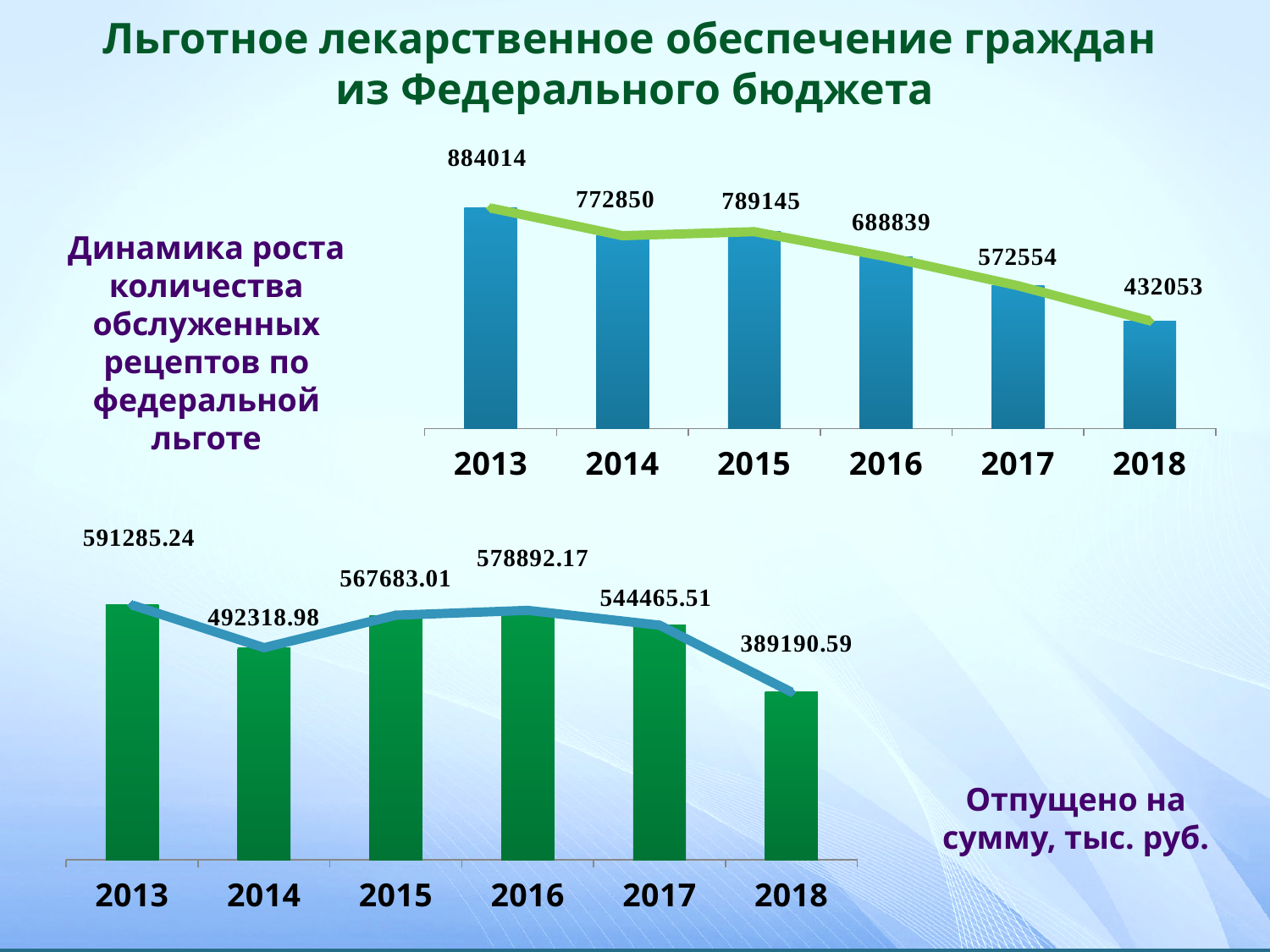
In the bottom chart, what is the value for 2016? 578892.17 In the top chart, what is the value for 2013? 884014 How many years are shown on the x axis of the top chart? 6 In the bottom chart, which year has the highest value? 2013 In the bottom chart, what is the difference between the values for 2017 and 2018? 155274.92 In the top chart, which year has the lowest value? 2018 In the top chart, what is the value for 2018? 432053 What kind of chart is the bottom chart? combination bar and line chart In the top chart, which is larger: the value for 2014 or the value for 2015? 2015 In the top chart, what is the difference between the values for 2013 and 2018? 451961 In the top chart, which year has the highest value? 2013 In the bottom chart, what is the value for 2018? 389190.59